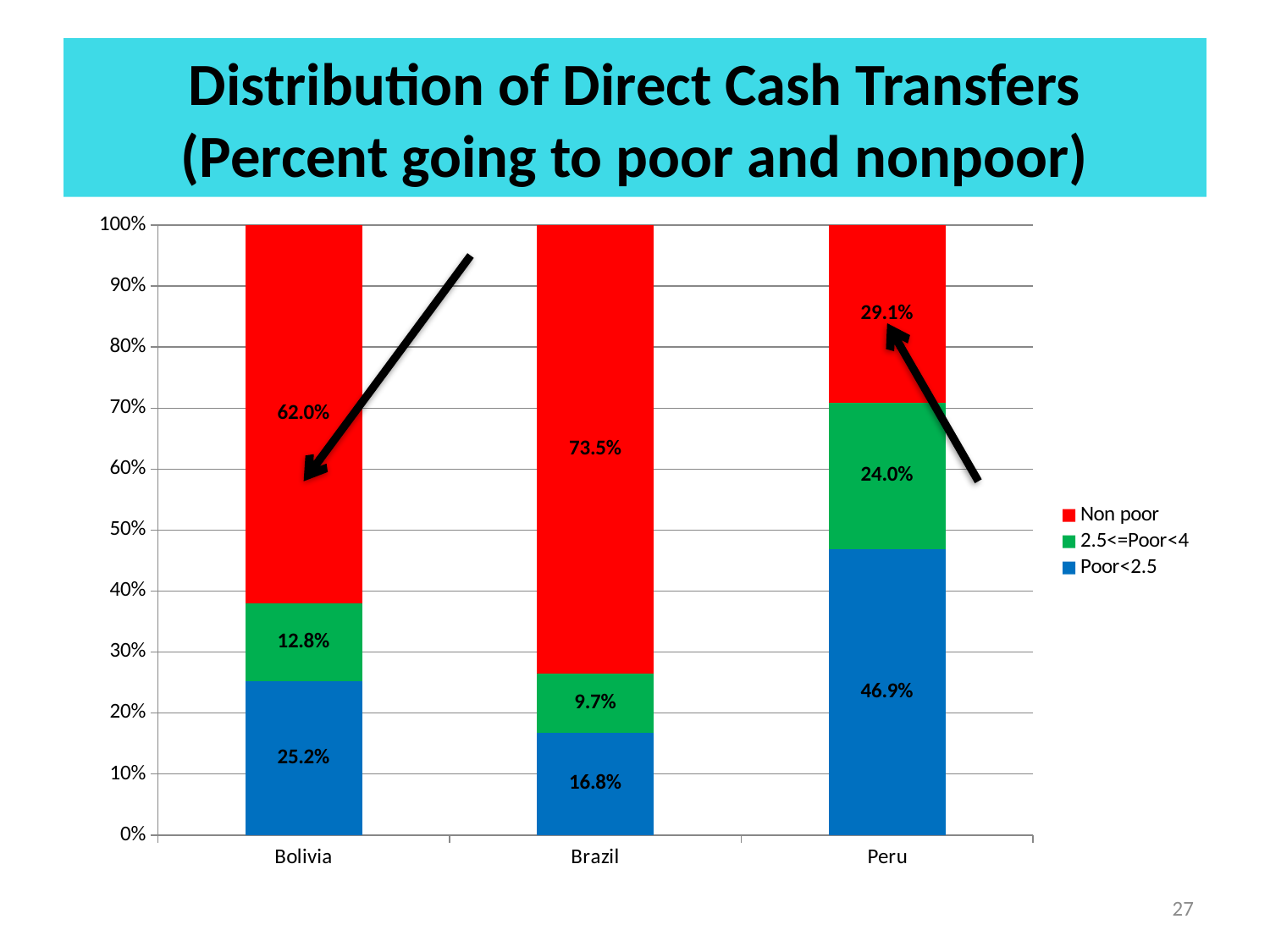
What is the Non poor share for Peru? 29.1% What percentage of direct cash transfers in Brazil goes to the Non poor? 73.5% What is the value for 2.5<=Poor<4 in Bolivia? 12.8% Which country has the lowest Poor<2.5 share? Brazil Which is larger: the Poor<2.5 share in Peru or in Bolivia? Peru What is the value for Poor<2.5 in Peru? 46.9% Which colour represents the Non poor series? Red How many series does the legend list? 3 What kind of chart is shown on the slide? Stacked bar chart Which country has the highest Non poor share? Brazil How many countries are shown on the x axis? 3 What is the difference between the Non poor shares of Brazil and Bolivia? 11.5%